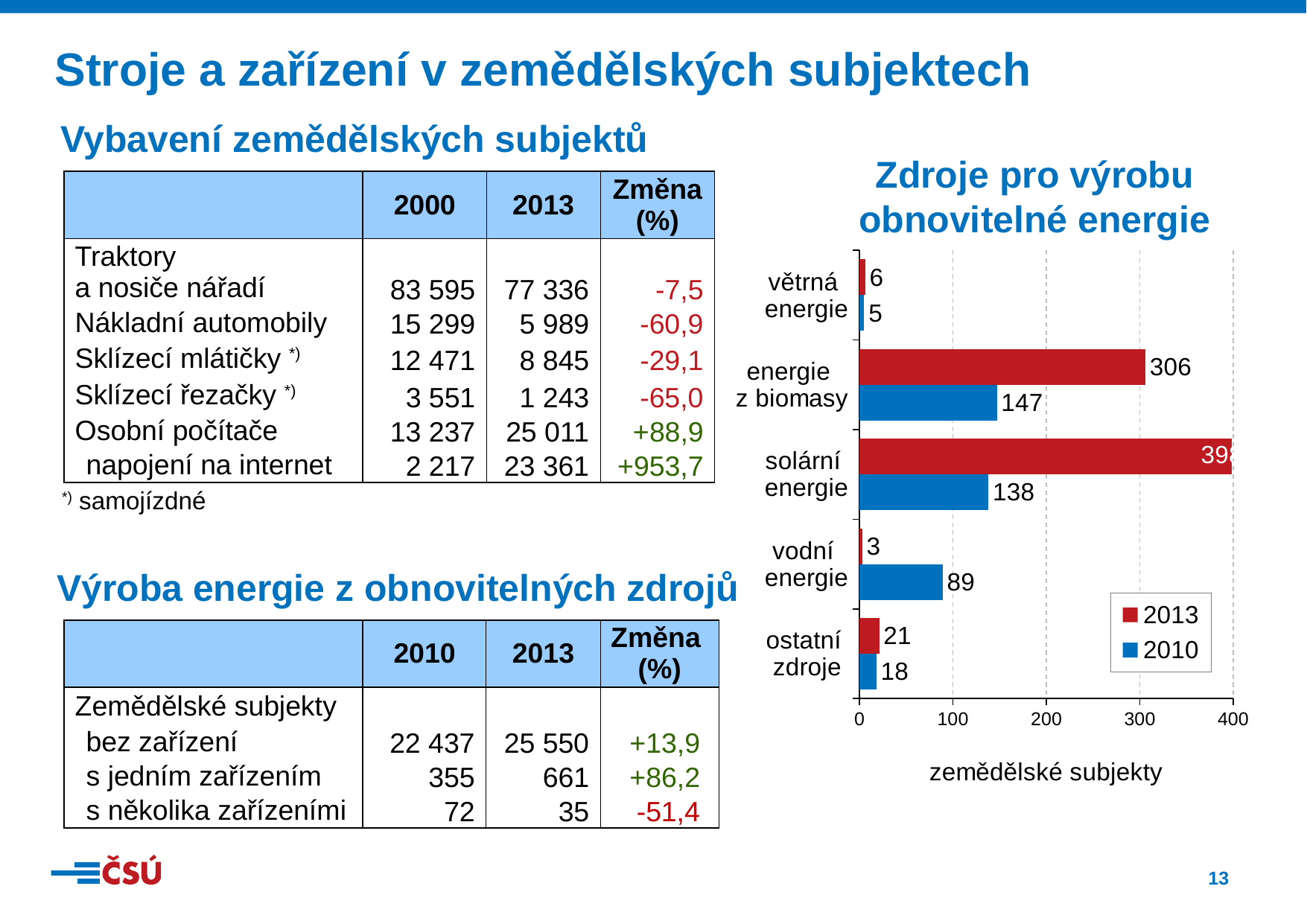
What kind of chart is 'Zdroje pro výrobu obnovitelné energie'? bar chart In the 'Zdroje pro výrobu obnovitelné energie' chart, which category has the lowest 2013 value? vodní energie In the 'Zdroje pro výrobu obnovitelné energie' chart, is the 2013 value for vodní energie larger or smaller than the 2010 value? smaller In the 'Zdroje pro výrobu obnovitelné energie' chart, which category has the highest 2010 value? energie z biomasy In the 'Zdroje pro výrobu obnovitelné energie' chart, what is the 2010 value for solární energie? 138 In the 'Zdroje pro výrobu obnovitelné energie' chart, what is the 2013 value for ostatní zdroje? 21 How many series does the legend of the 'Zdroje pro výrobu obnovitelné energie' chart list? 2 In the 'Zdroje pro výrobu obnovitelné energie' chart, what is the 2013 value for energie z biomasy? 306 In the 'Zdroje pro výrobu obnovitelné energie' chart, what is the difference between the 2013 and 2010 values for energie z biomasy? 159 How many categories are shown in the 'Zdroje pro výrobu obnovitelné energie' chart? 5 In the 'Zdroje pro výrobu obnovitelné energie' chart, what is the 2010 value for vodní energie? 89 In the 'Zdroje pro výrobu obnovitelné energie' chart, is the 2013 value for solární energie greater or less than 300? greater